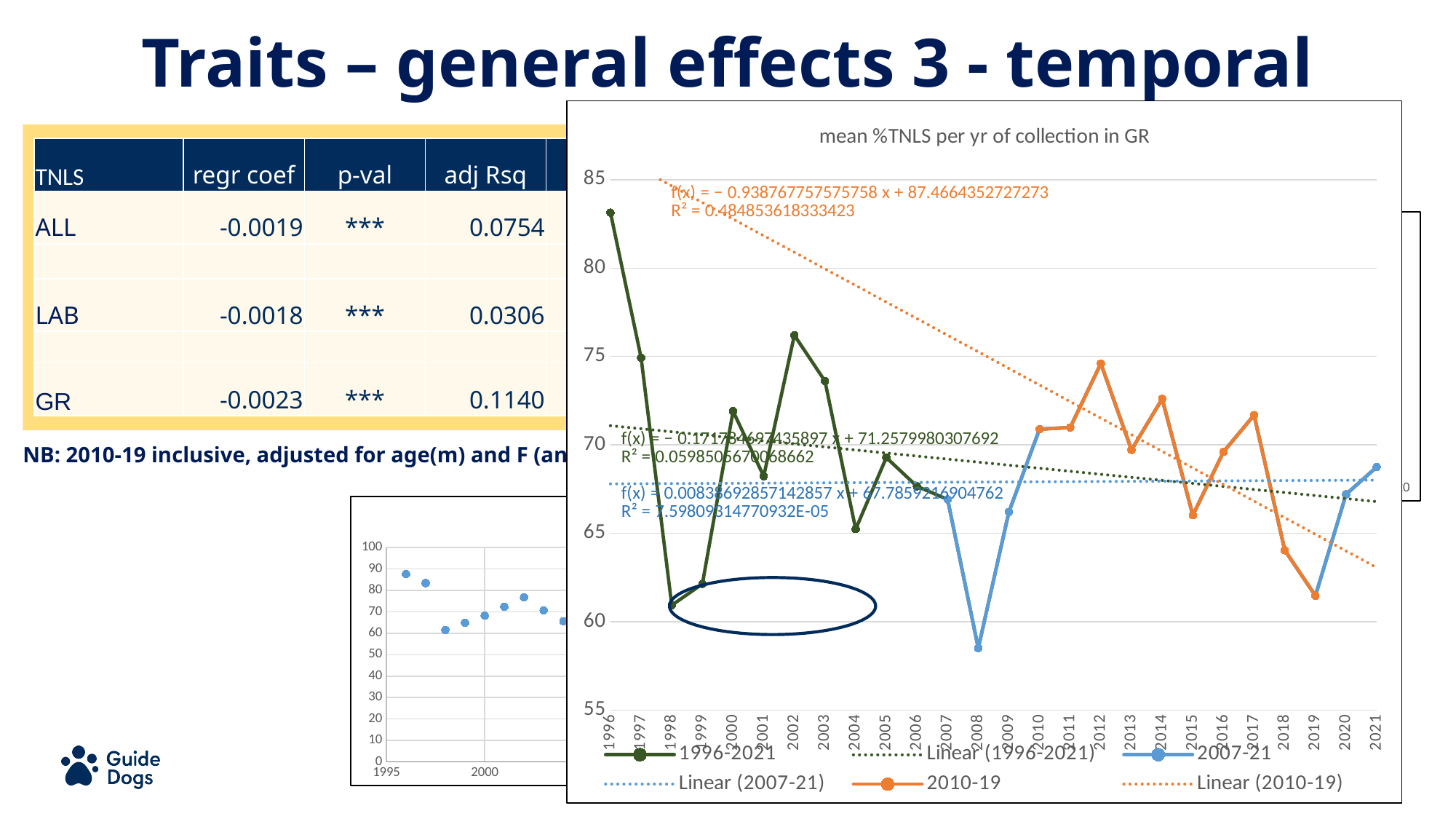
In the 'mean %TNLS per yr of collection in GR' chart, which year has the lowest value? 2008 What kind of chart is the chart titled 'mean %TNLS per yr of collection in GR'? line chart How many entries does the legend of the 'mean %TNLS per yr of collection in GR' chart list? 6 In the 'mean %TNLS per yr of collection in GR' chart, which year has the larger value, 2012 or 2019? 2012 What is the title of the chart on the right? mean %TNLS per yr of collection in GR How many years are shown on the x axis of the 'mean %TNLS per yr of collection in GR' chart? 26 In the 'mean %TNLS per yr of collection in GR' chart, does the dotted Linear (1996-2021) trendline rise or fall from left to right? fall In the 'mean %TNLS per yr of collection in GR' chart, which series is drawn in orange? 2010-19 In the 'mean %TNLS per yr of collection in GR' chart, is the value for 2008 greater or less than 60? less In the 'mean %TNLS per yr of collection in GR' chart, which year has the highest value? 1996 In the 'mean %TNLS per yr of collection in GR' chart, is the value for 1996 greater or less than 80? greater In the 'mean %TNLS per yr of collection in GR' chart, is the value for 2012 greater or less than 70? greater